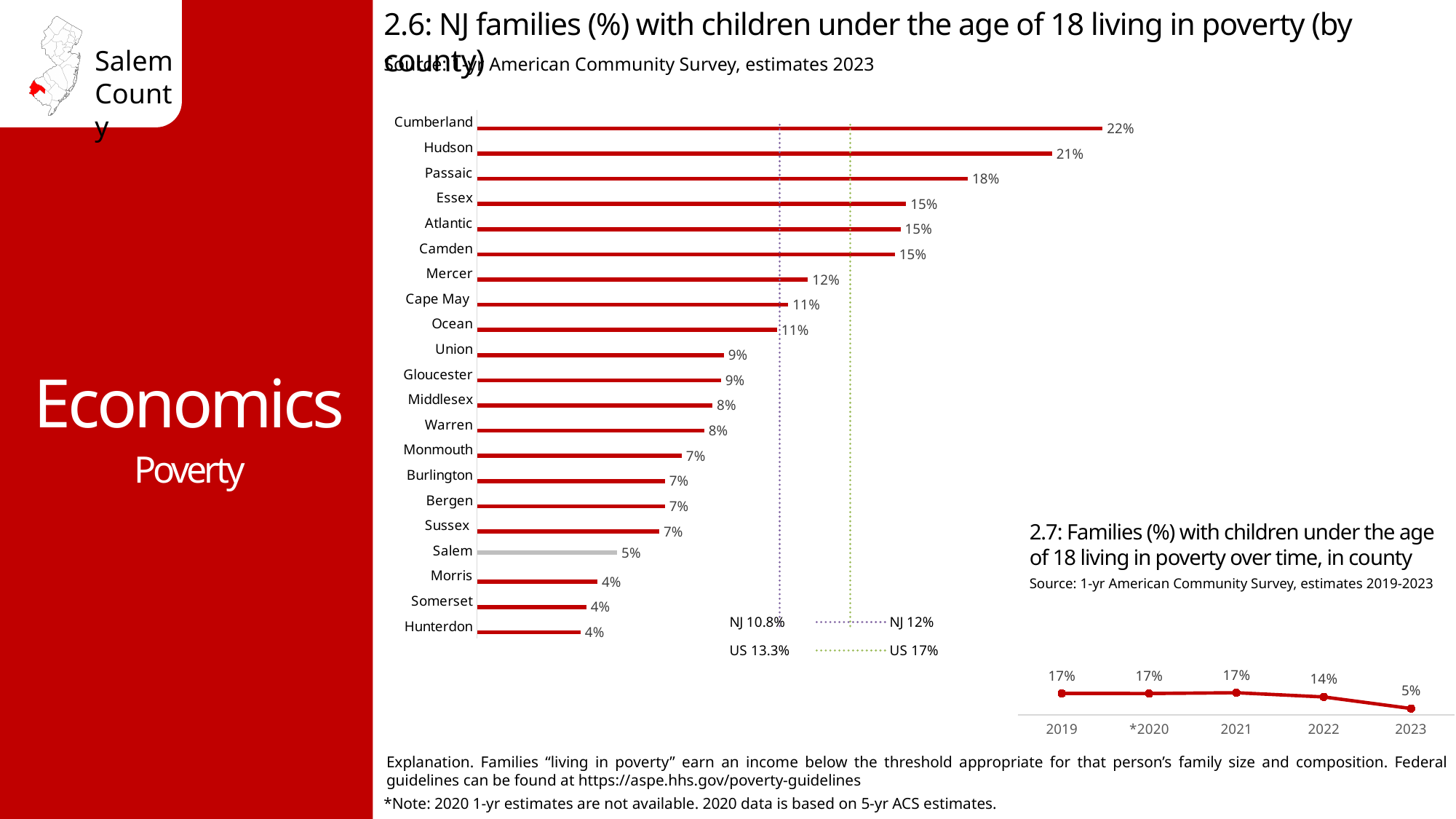
In chart 2.6 (by county), which county has the highest value? Cumberland In chart 2.6 (by county), what is the value for Cumberland? 22% In chart 2.7 (over time, in county), what is the difference between 2022 and 2023? 9% In chart 2.6 (by county), which is larger, the value for Passaic or the value for Mercer? Passaic In chart 2.6 (by county), what is the difference between Cumberland and Salem? 17% In chart 2.7 (over time, in county), do the values rise or fall from 2021 to 2023? Fall In chart 2.6 (by county), what is the value for Hudson? 21% What kind of chart is chart 2.6 (by county)? Bar chart In chart 2.7 (families in poverty over time, in county), what is the value for 2023? 5% In chart 2.6 (by county), how many counties are plotted? 21 In chart 2.6 (NJ families with children under 18 living in poverty by county), what is the value for Salem? 5%